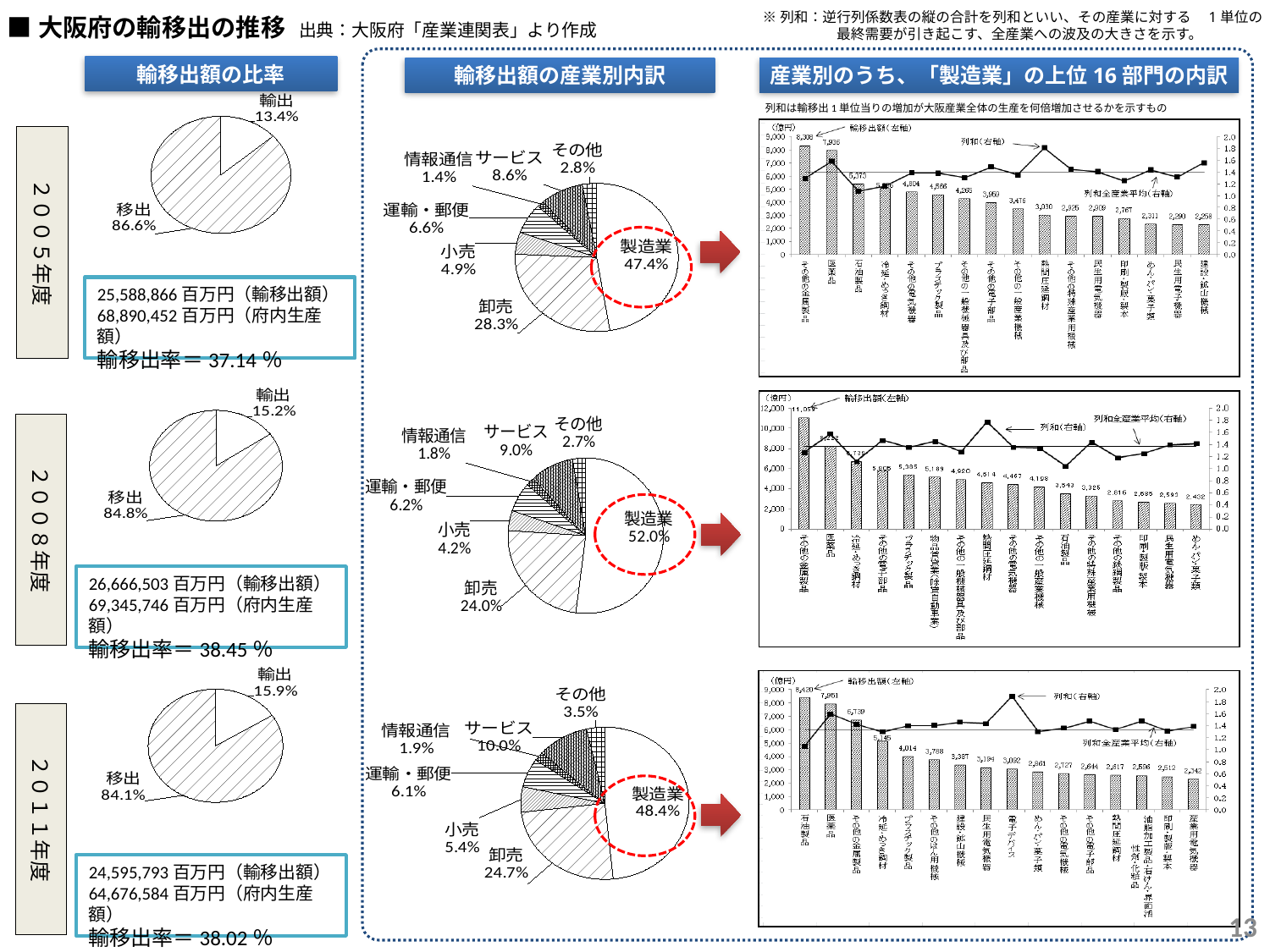
In the 2008年度 pie chart under 輸移出額の産業別内訳, which is larger, サービス or 運輸・郵便? サービス In the 2011年度 pie chart under 輸移出額の産業別内訳, which category has the largest share? 製造業 In the 2005年度 pie chart under 輸移出額の比率, what share is 輸出? 13.4% In the 2011年度 pie chart under 輸移出額の産業別内訳, what is the difference between the 製造業 share and the 卸売 share? 23.7% In the 2011年度 pie chart under 輸移出額の比率, what share is 移出? 84.1% Across the three pie charts under 輸移出額の比率, does the 輸出 share rise or fall from 2005年度 to 2011年度? rise What kind of chart is used under 輸移出額の比率 for each year? pie chart How many categories are shown in the 2005年度 pie chart under 輸移出額の産業別内訳? 7 In the 2005年度 pie chart under 輸移出額の産業別内訳, which category has the smallest share? 情報通信 In the 2005年度 chart under 産業別のうち、「製造業」の上位16部門の内訳, which category has the tallest bar? その他の金属製品 In the 2011年度 chart under 産業別のうち、「製造業」の上位16部門の内訳, what is the value of the first bar (石油製品)? 8,420 In the 2008年度 pie chart under 輸移出額の産業別内訳, what share is 製造業? 52.0%